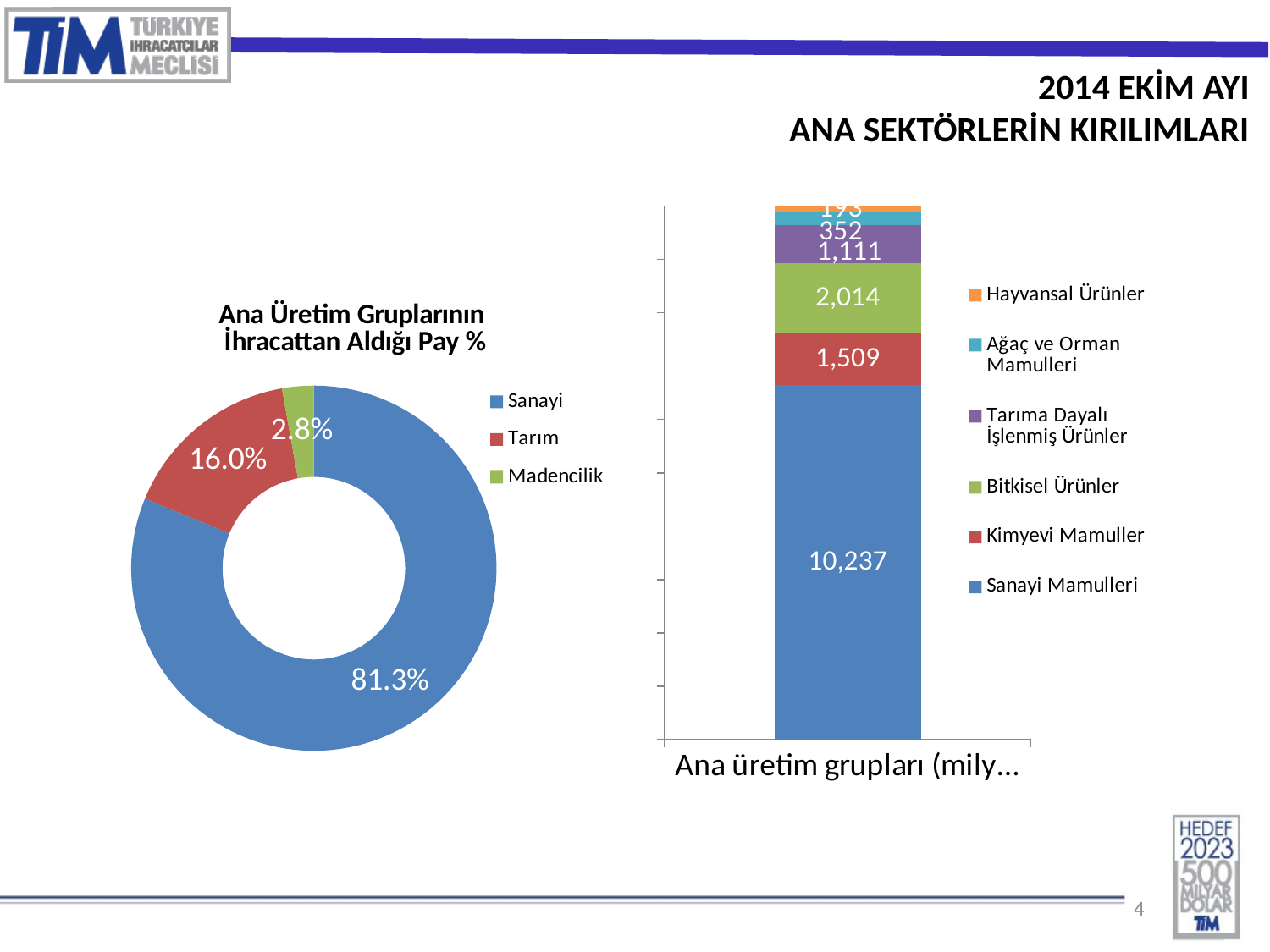
In the doughnut chart on the left, which category has the smallest share? Madencilik In the doughnut chart 'Ana Üretim Gruplarının İhracattan Aldığı Pay %', what share does Tarım have? 16.0% In the stacked bar chart on the right, what is the value for Tarıma Dayalı İşlenmiş Ürünler? 1,111 In the stacked bar chart on the right, how many series does the legend list? 6 In the doughnut chart on the left, what is the difference between the shares of Tarım and Madencilik? 13.2% In the stacked bar chart on the right, what is the value for Kimyevi Mamuller? 1,509 In the doughnut chart 'Ana Üretim Gruplarının İhracattan Aldığı Pay %', what share does Sanayi have? 81.3% In the doughnut chart on the left, how many categories does the legend list? 3 In the doughnut chart 'Ana Üretim Gruplarının İhracattan Aldığı Pay %', what share does Madencilik have? 2.8% In the stacked bar chart on the right, what is the value for Bitkisel Ürünler? 2,014 In the stacked bar chart on the right, which is larger, Bitkisel Ürünler or Kimyevi Mamuller? Bitkisel Ürünler In the stacked bar chart on the right, what is the value for Sanayi Mamulleri? 10,237